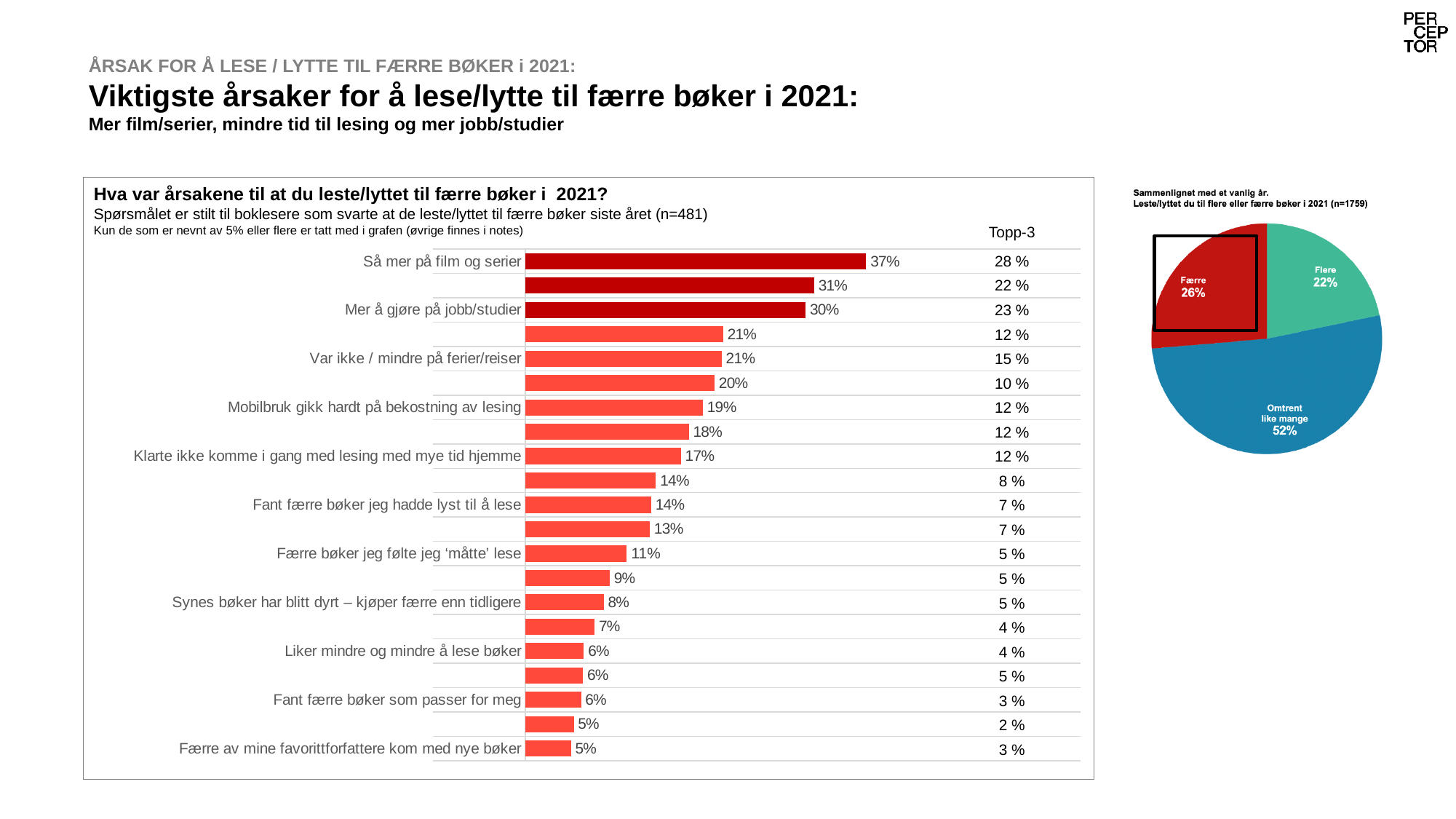
How many bars are shown in the bar chart? 21 What kind of chart is the large chart on the left? Bar chart In the bar chart, which is larger: 'Var ikke / mindre på ferier/reiser' or 'Klarte ikke komme i gang med lesing med mye tid hjemme'? Var ikke / mindre på ferier/reiser In the pie chart, what share is 'Færre'? 26% In the bar chart, which category has the highest value? Så mer på film og serier In the bar chart, what is the difference between 'Så mer på film og serier' and 'Mer å gjøre på jobb/studier'? 7% In the bar chart, what is the value for 'Mer å gjøre på jobb/studier'? 30% How many slices does the pie chart have? 3 In the bar chart, what is the value for 'Mobilbruk gikk hardt på bekostning av lesing'? 19% In the pie chart, what share is 'Omtrent like mange'? 52% In the bar chart, what is the value for 'Så mer på film og serier'? 37% In the bar chart, what is the Topp-3 value for 'Så mer på film og serier'? 28 %